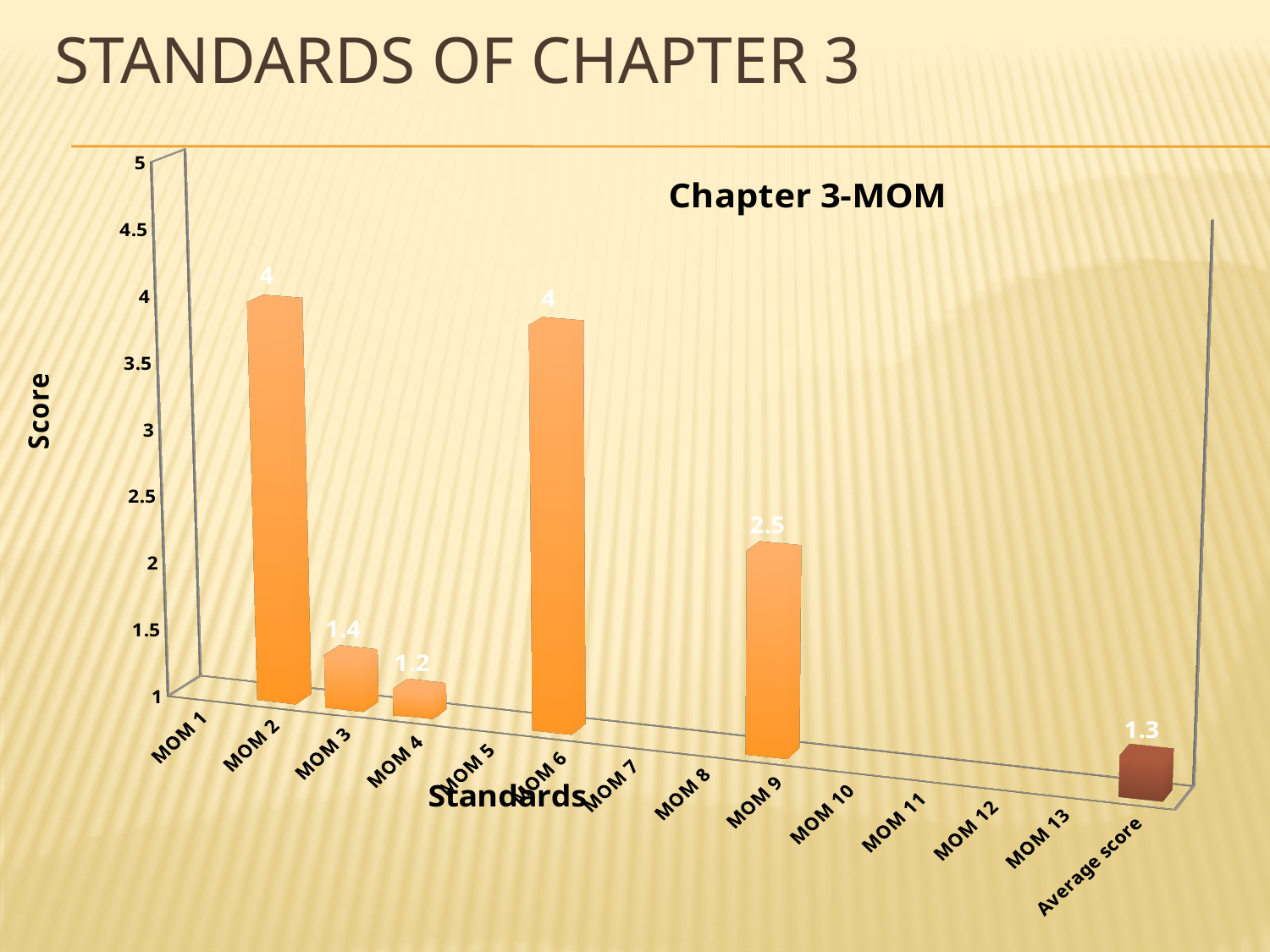
How many categories are listed along the x axis? 14 What is the value shown for Average score? 1.3 What is the difference between the scores for MOM 9 and MOM 3? 1.1 What is the difference between the scores for MOM 2 and MOM 9? 1.5 What is the score for MOM 3? 1.4 What is the title of the chart? Chapter 3-MOM What is the score for MOM 6? 4 Which standard has the lowest labelled score? MOM 4 What is the score for MOM 2? 4 What kind of chart is shown on the slide? Bar chart Which has a higher score, MOM 3 or MOM 4? MOM 3 What is the score for MOM 9? 2.5